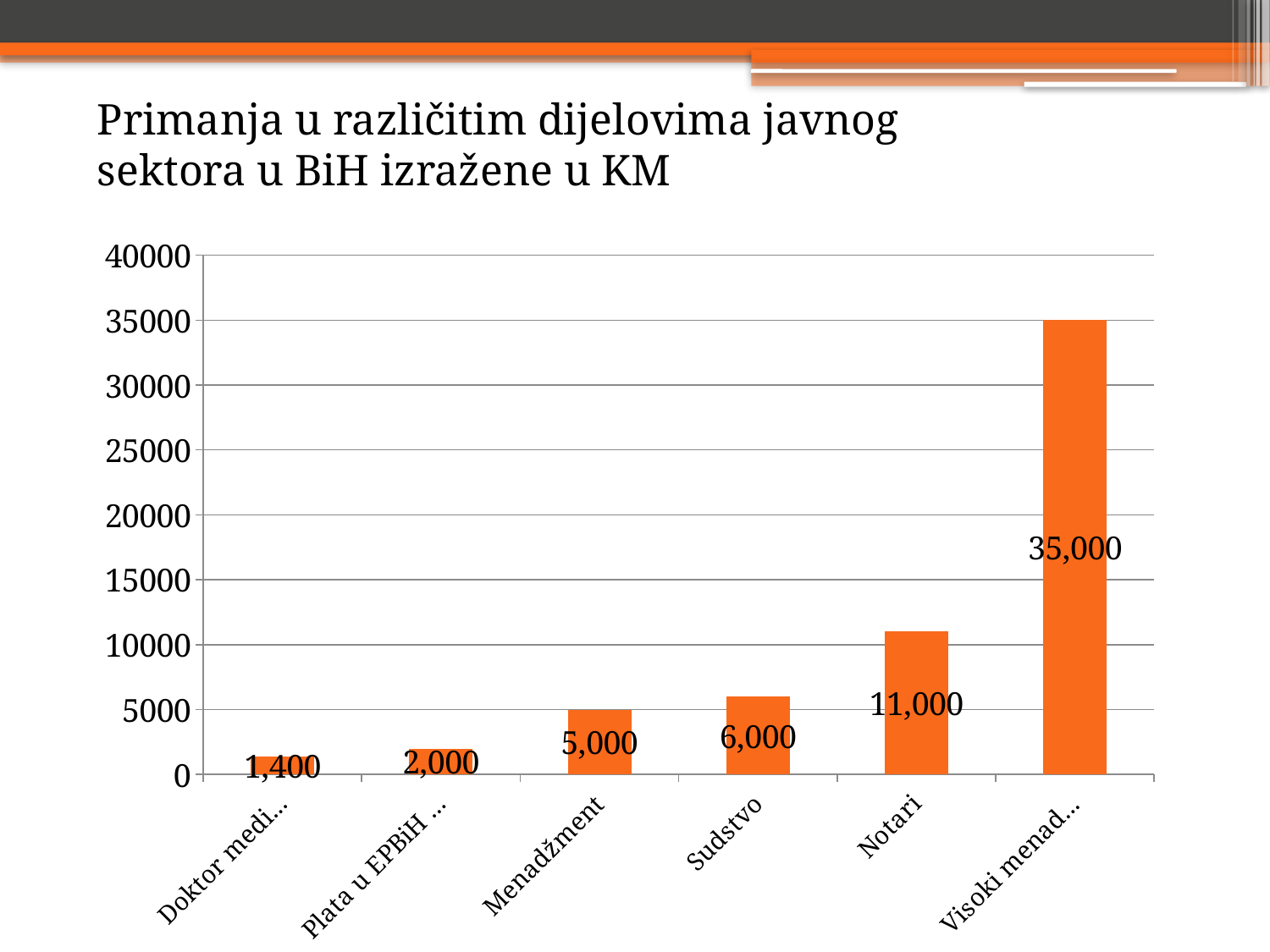
What kind of chart is shown on the slide? Bar chart Which is larger, the value for Notari or the value for Sudstvo? Notari What is the value for Notari? 11,000 What is the value of the rightmost bar in the chart? 35,000 What is the value for Sudstvo? 6,000 What is the difference between the values for Notari and Sudstvo? 5,000 How many bars are shown in the chart? 6 What is the highest value shown in the chart? 35,000 What is the lowest value shown in the chart? 1,400 What is the value for Menadžment? 5,000 Is the value for Notari greater or less than 10000? greater What is the difference between the values for Sudstvo and Menadžment? 1,000